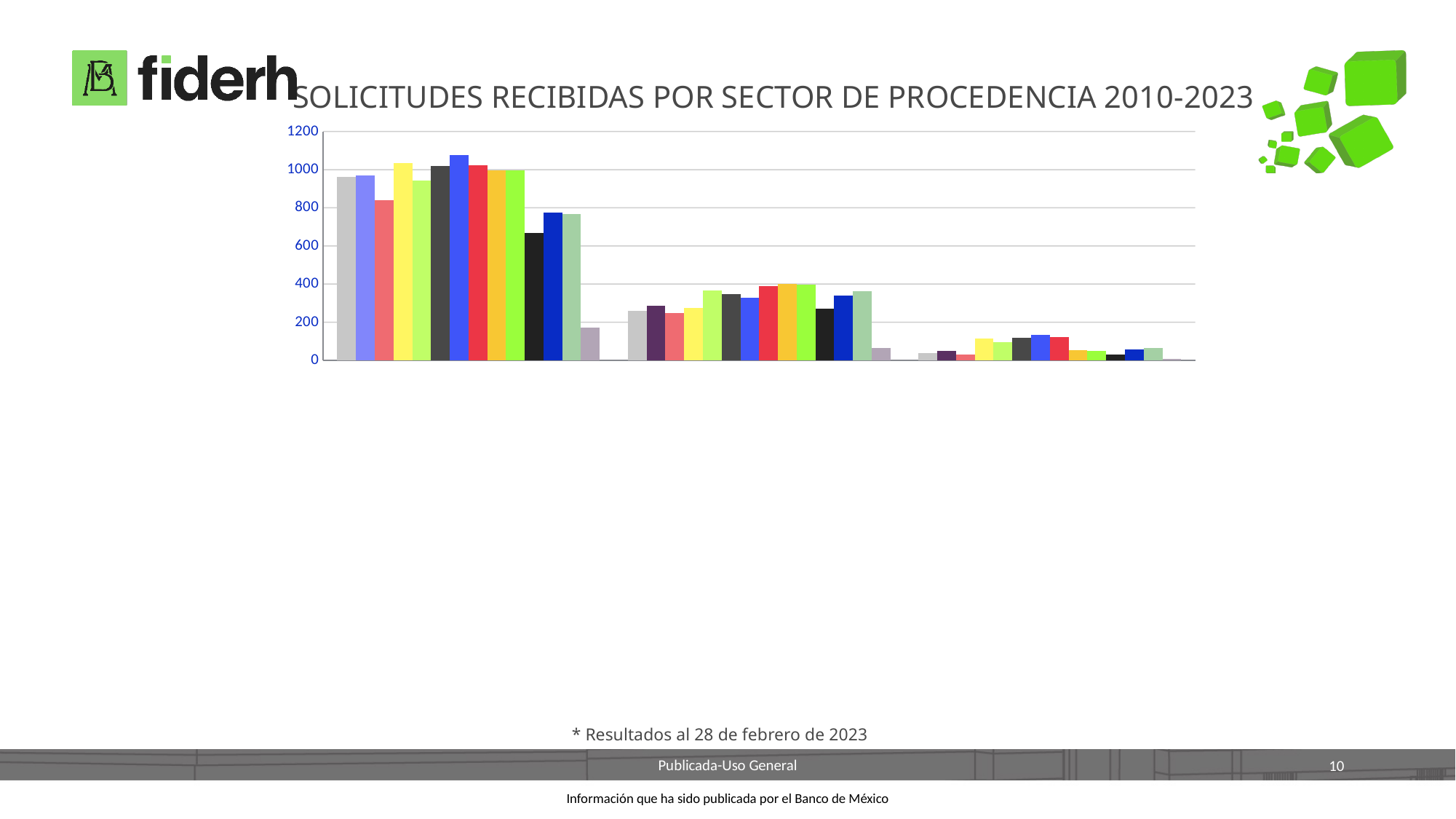
Which group of bars, leftmost, middle or rightmost, contains the tallest bar? leftmost What kind of chart is shown on the slide? bar chart What is the highest value shown on the vertical axis? 1200 Is the tallest bar in the leftmost group larger or smaller than the tallest bar in the middle group? larger Is the tallest bar in the middle group greater or less than 600? less Which group of bars, leftmost, middle or rightmost, has the lowest values overall? rightmost Is the tallest bar in the rightmost group greater or less than 200? less What is the title of the chart? SOLICITUDES RECIBIDAS POR SECTOR DE PROCEDENCIA 2010-2023 How many groups of bars does the chart show? 3 Is the tallest bar in the leftmost group greater or less than 1000? greater Do the bar heights generally rise or fall moving from the leftmost group to the rightmost group? fall